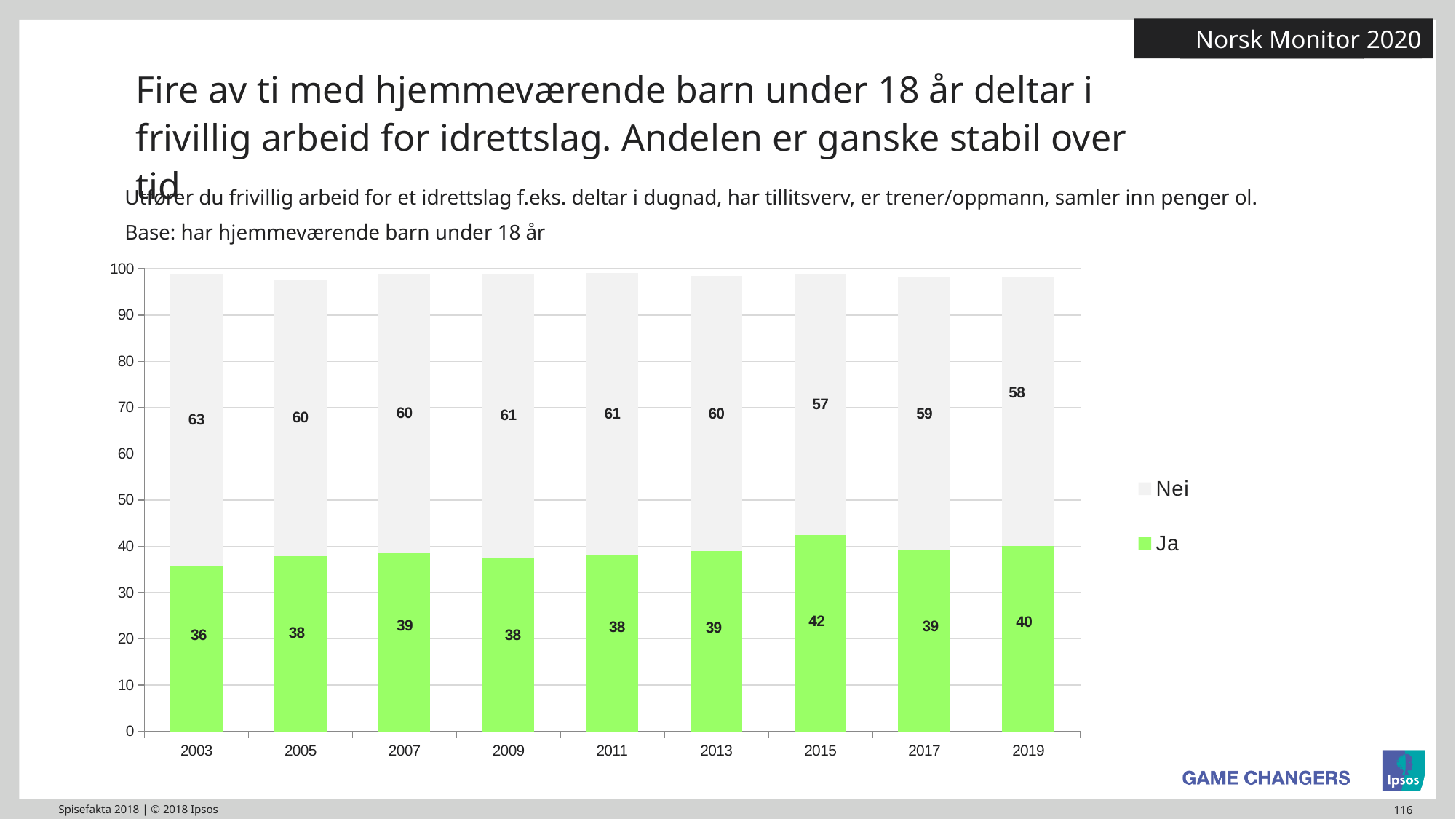
In which year is the "Ja" value highest? 2015 What is the value for "Ja" in 2015? 42 How many years are shown on the x axis? 9 What kind of chart is shown on the slide? Stacked bar chart Which is larger: the "Ja" value in 2015 or the "Ja" value in 2003? 2015 What is the value for "Nei" in 2003? 63 How many series does the legend list? 2 What is the difference between the "Nei" value and the "Ja" value in 2003? 27 In which year is the "Ja" value lowest? 2003 In which year is the "Nei" value lowest? 2015 What is the total of the stacked bar for 2019? 98 What is the value for "Ja" in 2019? 40